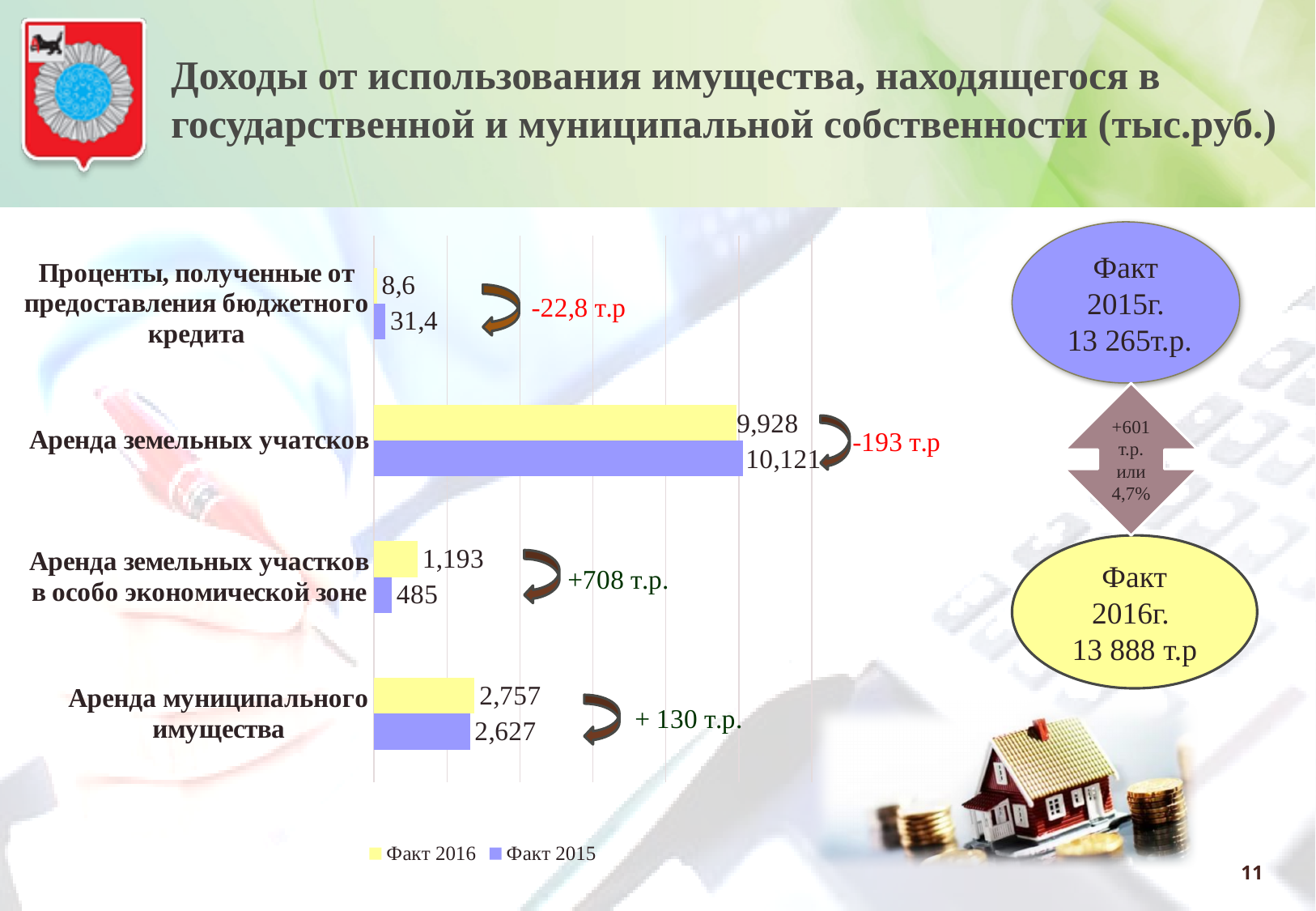
How many categories are shown in the chart? 4 By how much does the Факт 2015 value for Аренда земельных участков exceed the Факт 2016 value? 193 What is the Факт 2016 value for Аренда земельных участков? 9,928 What is the difference between the Факт 2016 and Факт 2015 values for Аренда муниципального имущества? 130 What is the Факт 2016 value for Аренда земельных участков в особо экономической зоне? 1,193 What is the Факт 2016 value for Аренда муниципального имущества? 2,757 For Аренда земельных участков в особо экономической зоне, which is larger: the Факт 2016 value or the Факт 2015 value? Факт 2016 How many series does the legend list? 2 What is the Факт 2015 value for Аренда земельных участков? 10,121 Which category has the highest Факт 2016 value? Аренда земельных участков What is the Факт 2015 value for Проценты, полученные от предоставления бюджетного кредита? 31,4 Which category has the lowest Факт 2015 value? Проценты, полученные от предоставления бюджетного кредита